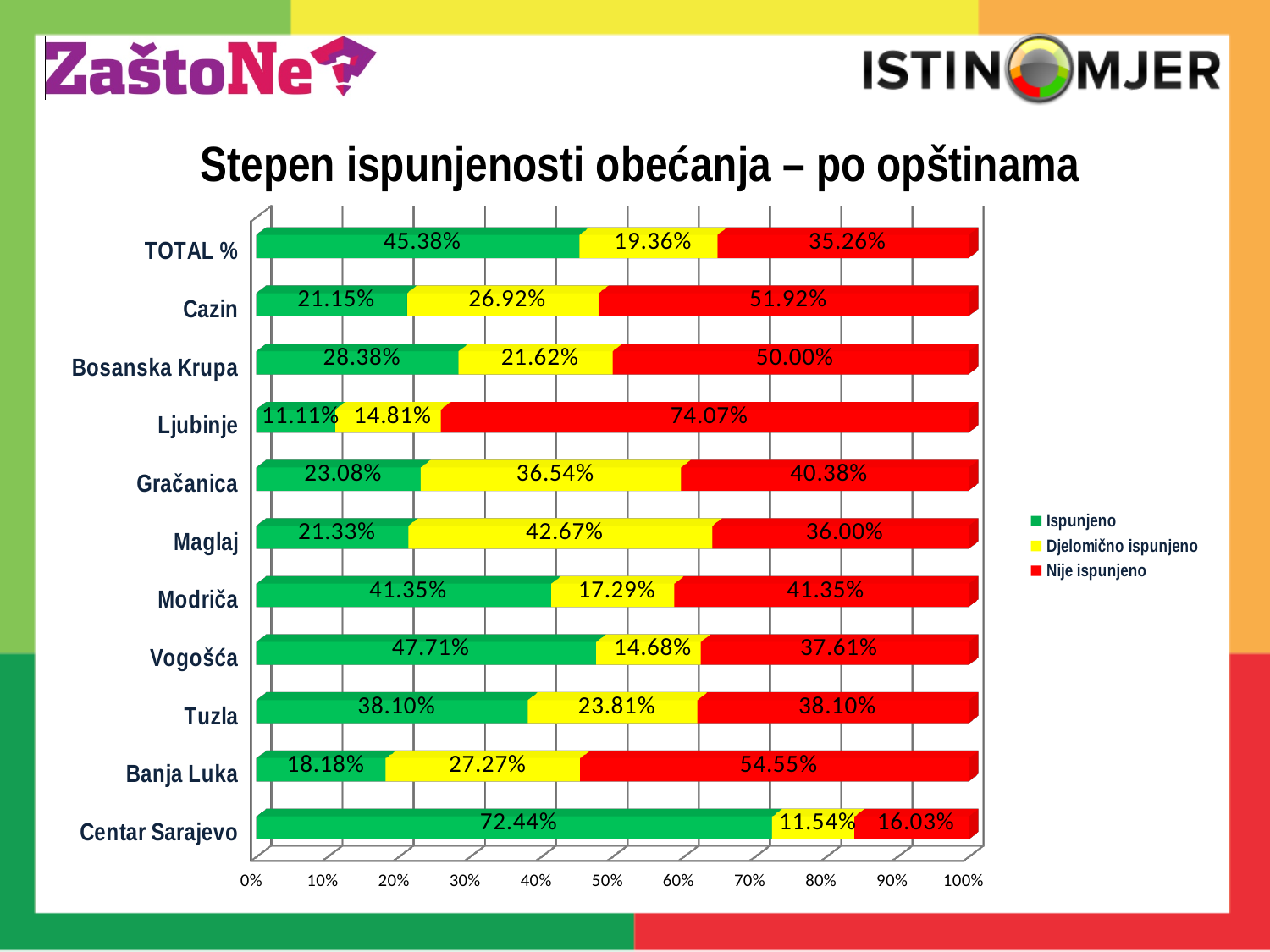
What is the Nije ispunjeno value for Ljubinje? 74.07% Which category has the highest Ispunjeno value? Centar Sarajevo How many series does the legend list? 3 What is the Ispunjeno value for TOTAL %? 45.38% What is the Djelomično ispunjeno value for Maglaj? 42.67% Which category has the highest Nije ispunjeno value? Ljubinje Which category has the lowest Ispunjeno value? Ljubinje What is the Ispunjeno value for Centar Sarajevo? 72.44% What type of chart is shown on the slide? Stacked bar chart What is the difference between the Nije ispunjeno values for Banja Luka and Cazin? 2.63% Which is larger, the Ispunjeno value for Vogošća or for Modriča? Vogošća How many categories are shown on the chart? 11